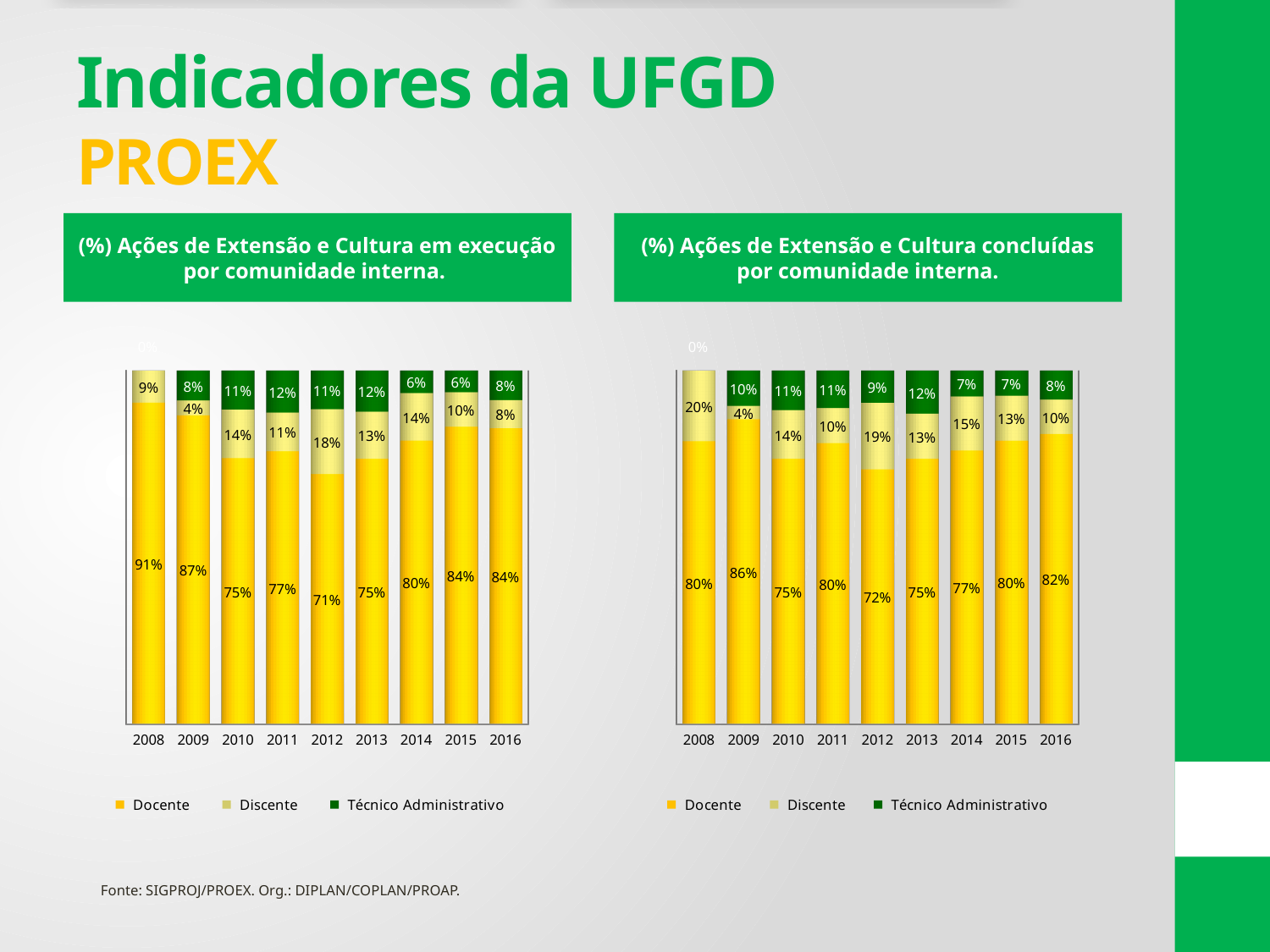
In the chart "(%) Ações de Extensão e Cultura em execução por comunidade interna", what is the Docente value for 2012? 71% In the chart "(%) Ações de Extensão e Cultura concluídas por comunidade interna", what is the Técnico Administrativo value for 2013? 12% In the chart "(%) Ações de Extensão e Cultura concluídas por comunidade interna", is the Docente value larger in 2012 or in 2016? 2016 How many series does the legend of the chart "(%) Ações de Extensão e Cultura em execução por comunidade interna" list? 3 In the chart "(%) Ações de Extensão e Cultura em execução por comunidade interna", what is the difference between the Docente values for 2008 and 2016? 7% In the chart "(%) Ações de Extensão e Cultura concluídas por comunidade interna", what is the Docente value for 2009? 86% In the chart "(%) Ações de Extensão e Cultura em execução por comunidade interna", which year has the highest Docente value? 2008 How many years are shown on the x axis of the chart "(%) Ações de Extensão e Cultura concluídas por comunidade interna"? 9 What kind of chart is "(%) Ações de Extensão e Cultura concluídas por comunidade interna"? Stacked bar chart In the chart "(%) Ações de Extensão e Cultura em execução por comunidade interna", which year has the lowest Docente value? 2012 In the chart "(%) Ações de Extensão e Cultura concluídas por comunidade interna", which year has the highest Discente value? 2008 In the chart "(%) Ações de Extensão e Cultura em execução por comunidade interna", what is the Discente value for 2010? 14%